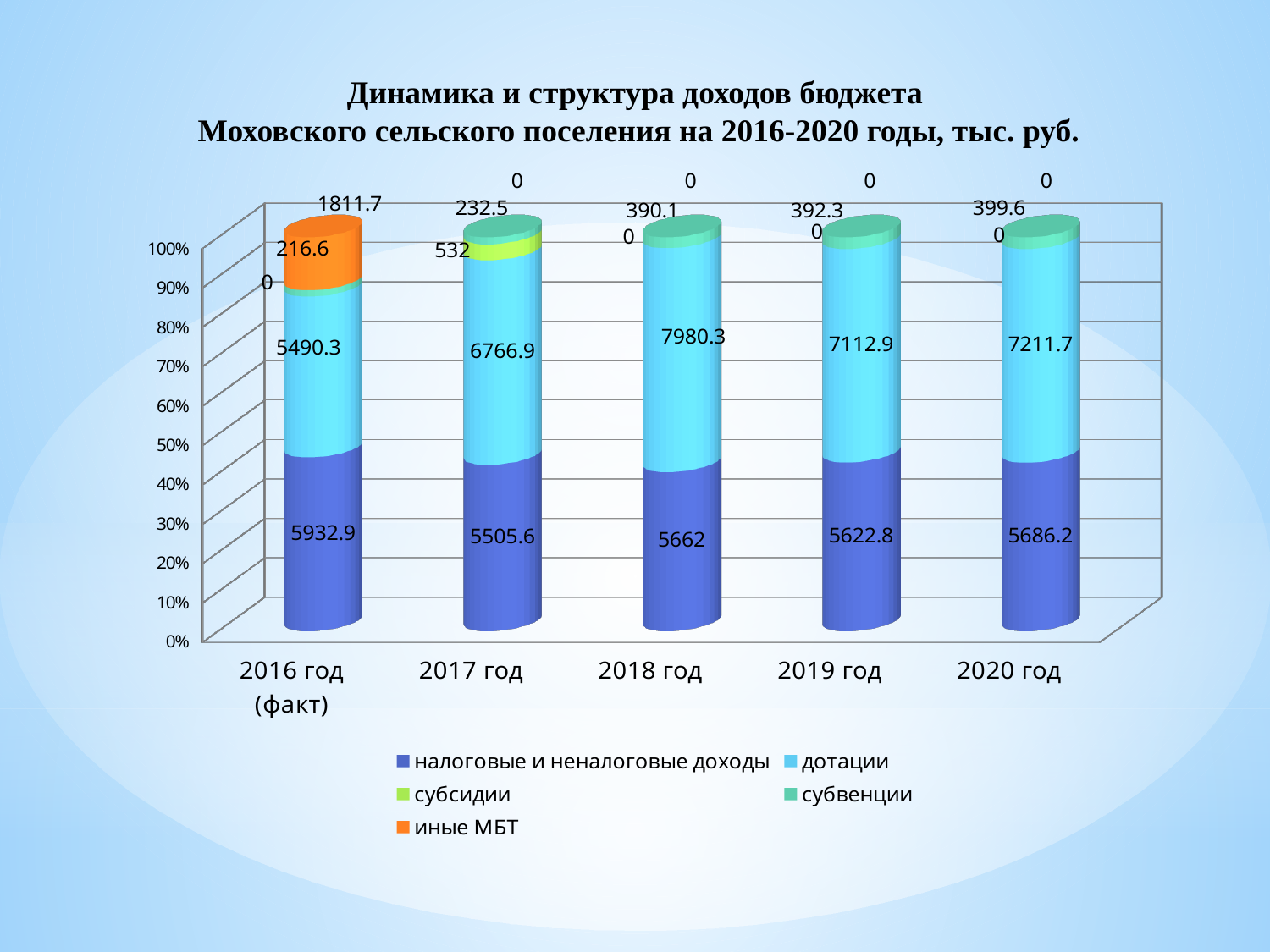
What kind of chart is shown on the slide? Stacked bar chart How many years are shown on the x axis? 5 In which year is the value of налоговые и неналоговые доходы the lowest? 2017 год What is the value of субсидии for 2017 год? 532 How many series does the legend list? 5 Which is larger: субвенции in 2019 год or субвенции in 2020 год? 2020 год In which year is the value of дотации the highest? 2018 год What is the value of дотации for 2018 год? 7980.3 What is the value of налоговые и неналоговые доходы for 2016 год (факт)? 5932.9 Do the values of субвенции rise or fall from 2016 год to 2020 год? Rise What is the value of иные МБТ for 2016 год (факт)? 1811.7 What is the difference between дотации in 2018 год and 2017 год? 1213.4